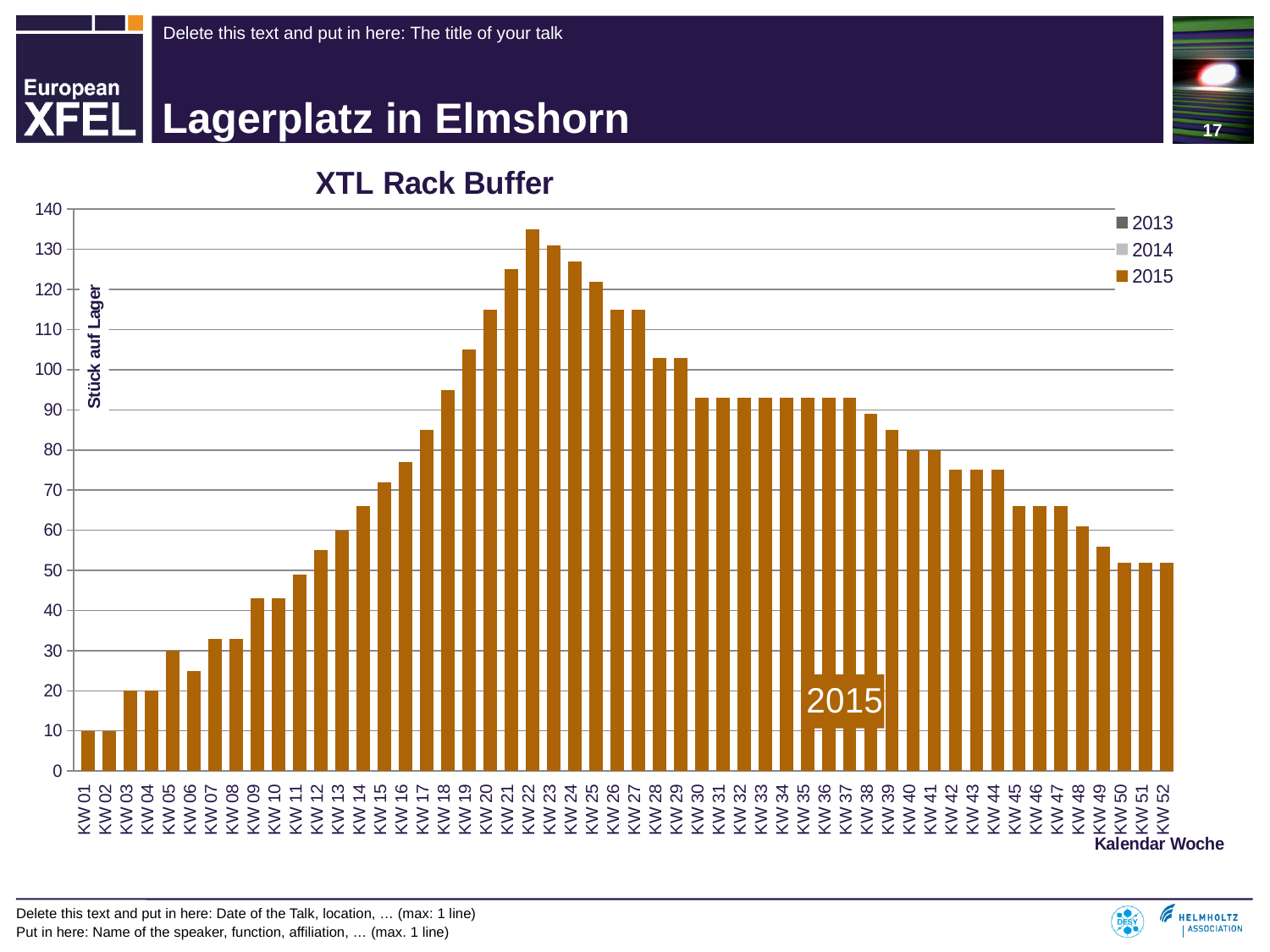
Is the value for KW 30 greater or less than 90? greater What type of chart is shown on the slide? bar chart Do the values rise or fall from KW 01 to KW 22? rise What is the value for KW 05? 30 Which calendar week has the highest value? KW 22 What is the value for KW 01? 10 How many calendar weeks (categories) are shown on the x axis? 52 Which is larger, the value for KW 22 or the value for KW 30? KW 22 Is the value for KW 10 greater or less than 50? less Is the value for KW 22 greater or less than 130? greater What is the title of the chart? XTL Rack Buffer How many series does the legend list? 3